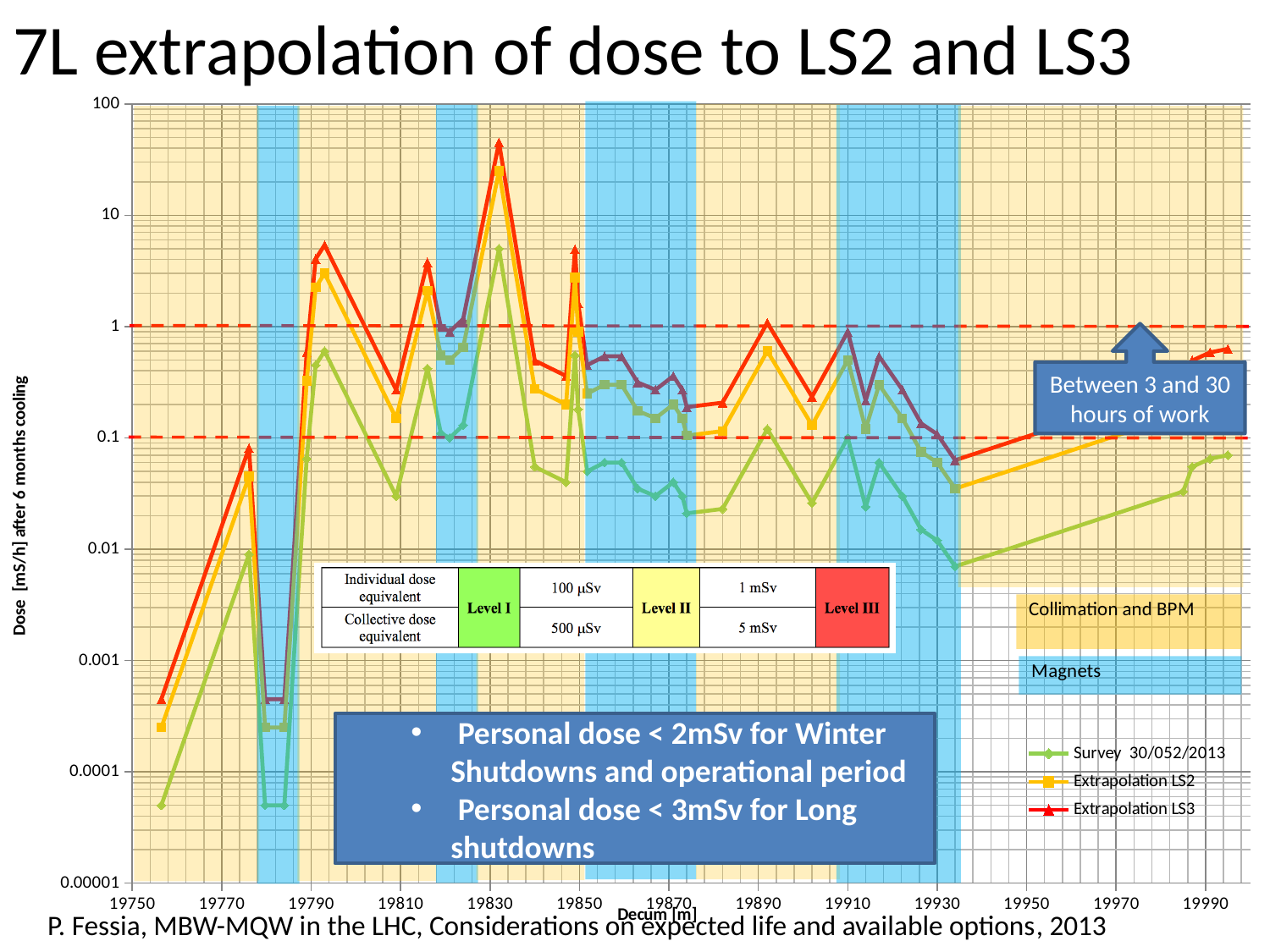
Which series reaches the highest value on the chart? Extrapolation LS3 Is the Survey 30/052/2013 value near Decum 19830 greater or less than 1? greater What is the highest tick value shown on the vertical axis? 100 What kind of chart is shown on the slide? line chart Is the peak value of the Extrapolation LS3 series near Decum 19830 greater or less than 10? greater Do the series values rise or fall between Decum 19755 and Decum 19775? rise What is the label of the vertical axis of the chart? Dose [mS/h] after 6 months cooling How many series does the chart legend list? 3 Which series has the lowest values across the chart? Survey 30/052/2013 What are the three series listed in the chart legend? Survey 30/052/2013, Extrapolation LS2, Extrapolation LS3 Is the Survey 30/052/2013 value at the first point near Decum 19755 greater or less than 0.0001? less Near Decum 19830, which is larger: the Extrapolation LS3 value or the Survey 30/052/2013 value? Extrapolation LS3